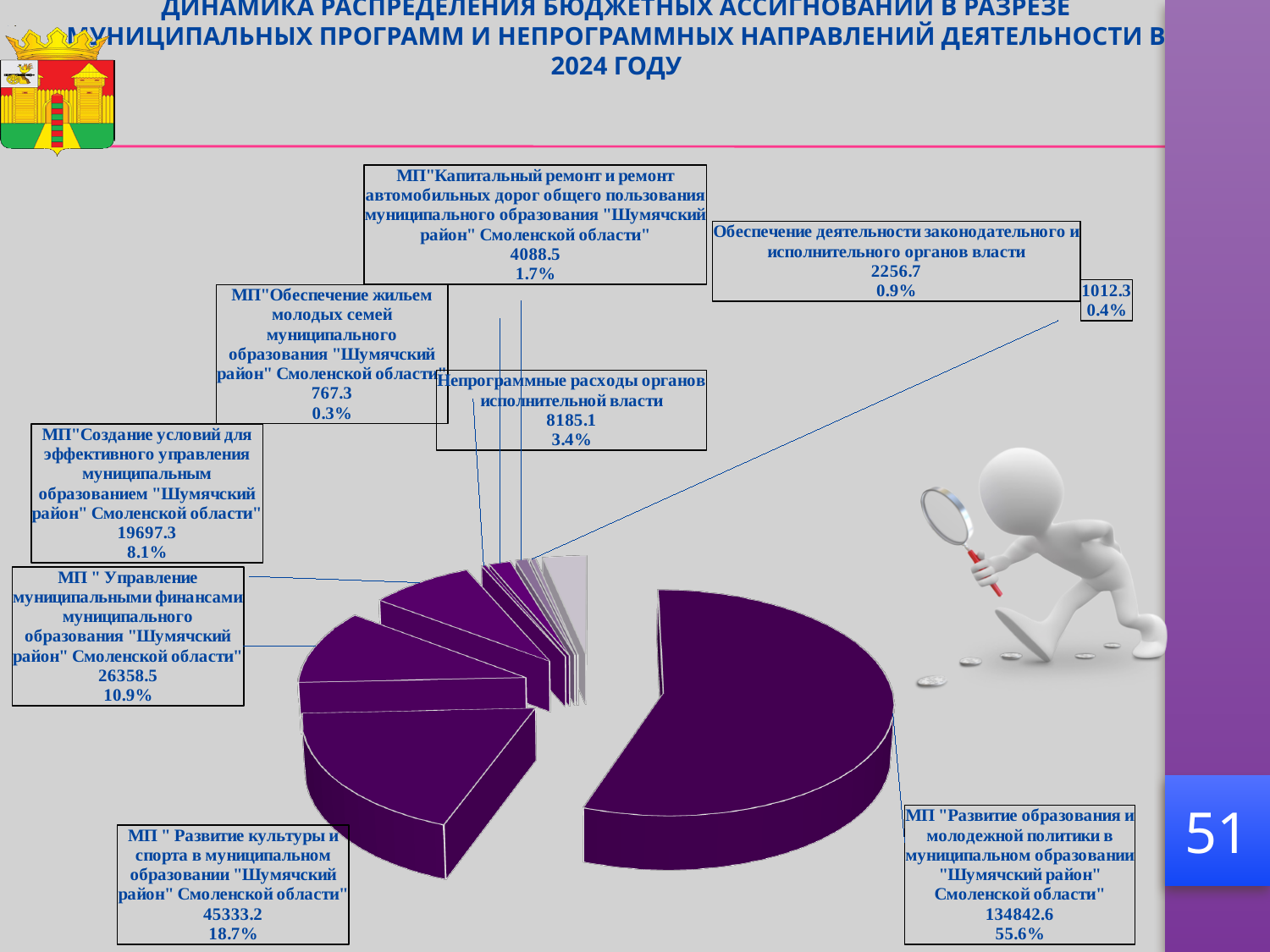
What is the value for Непрограммные расходы органов исполнительной власти? 8185.1 What percentage is shown for МП "Управление муниципальными финансами"? 10.9% What is the difference between the values for МП "Развитие культуры и спорта" and МП "Управление муниципальными финансами"? 18974.7 Which category has the largest share of the pie? МП "Развитие образования и молодежной политики" What percentage is shown for МП "Обеспечение жильем молодых семей"? 0.3% Which named category has the smallest value? МП "Обеспечение жильем молодых семей" What is the value for МП "Развитие культуры и спорта"? 45333.2 What is the value for МП "Развитие образования и молодежной политики"? 134842.6 Which is larger: the value for МП "Создание условий для эффективного управления" or Непрограммные расходы органов исполнительной власти? МП "Создание условий для эффективного управления" What share of the pie does МП "Развитие образования и молодежной политики" represent? 55.6% What year does the chart title refer to? 2024 What type of chart is shown on the slide? pie chart